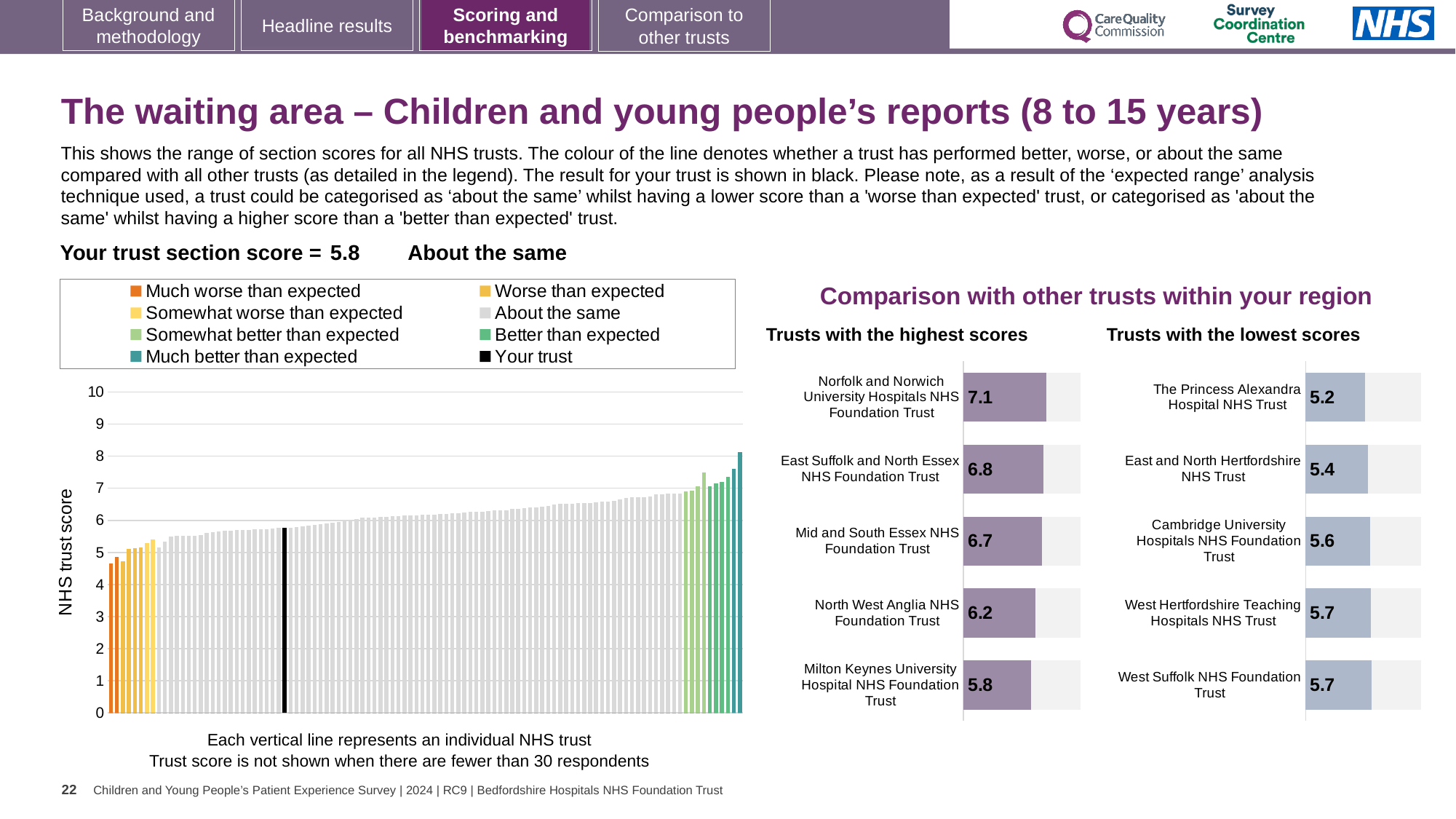
In the 'Trusts with the highest scores' chart, which trust has the highest score? Norfolk and Norwich University Hospitals NHS Foundation Trust In the 'Trusts with the lowest scores' chart, which has the larger score: East and North Hertfordshire NHS Trust or West Hertfordshire Teaching Hospitals NHS Trust? West Hertfordshire Teaching Hospitals NHS Trust In the 'Trusts with the highest scores' chart, how many trusts are listed? 5 What is the trust section score shown for your trust on the slide? 5.8 In the NHS trust score chart on the left, do the bar values rise or fall from left to right? rise In the 'Trusts with the highest scores' chart, what is the difference between the scores of Norfolk and Norwich University Hospitals NHS Foundation Trust and Milton Keynes University Hospital NHS Foundation Trust? 1.3 In the 'Trusts with the lowest scores' chart, what is the difference between the scores of Cambridge University Hospitals NHS Foundation Trust and The Princess Alexandra Hospital NHS Trust? 0.4 In the 'Trusts with the highest scores' chart, what is the score for Norfolk and Norwich University Hospitals NHS Foundation Trust? 7.1 In the 'Trusts with the lowest scores' chart, what is the score for Cambridge University Hospitals NHS Foundation Trust? 5.6 How many entries does the legend of the NHS trust score chart on the left list? 8 In the NHS trust score chart on the left, is the value of the lowest bar greater or less than 5? less In the 'Trusts with the lowest scores' chart, which trust has the lowest score? The Princess Alexandra Hospital NHS Trust